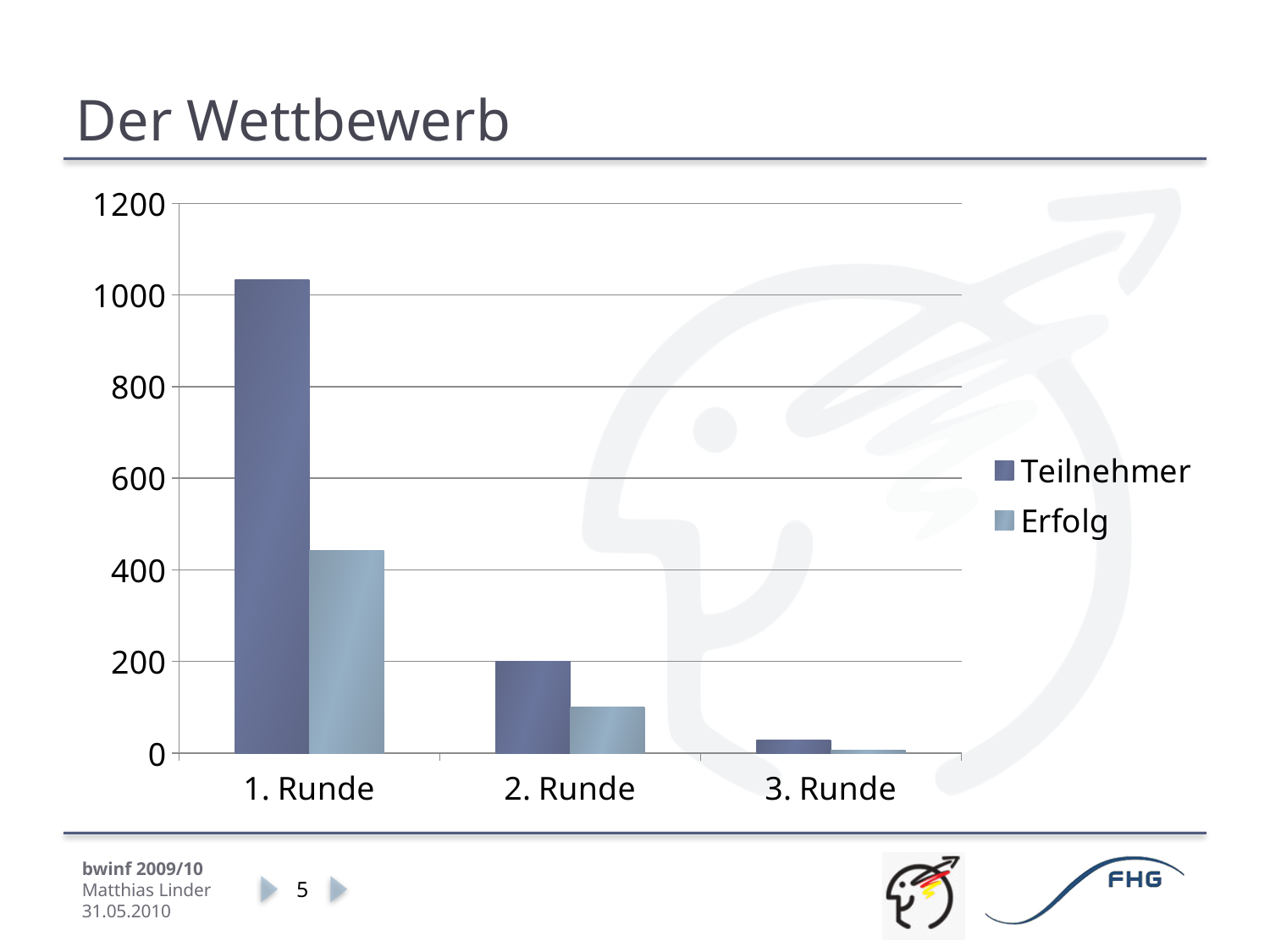
Is the Erfolg value for 2. Runde greater or less than 200? less Which category has the highest Teilnehmer value? 1. Runde Which category has the lowest Erfolg value? 3. Runde Which is larger in 2. Runde, Teilnehmer or Erfolg? Teilnehmer How many categories are shown on the x axis of the chart? 3 Do the Teilnehmer values rise or fall from 1. Runde to 3. Runde? fall What kind of chart is shown on the slide? bar chart Is the Teilnehmer value for 1. Runde greater or less than 800? greater Is the Erfolg value for 1. Runde greater or less than 400? greater Which series is shown in the lighter blue colour in the legend? Erfolg How many series does the chart's legend list? 2